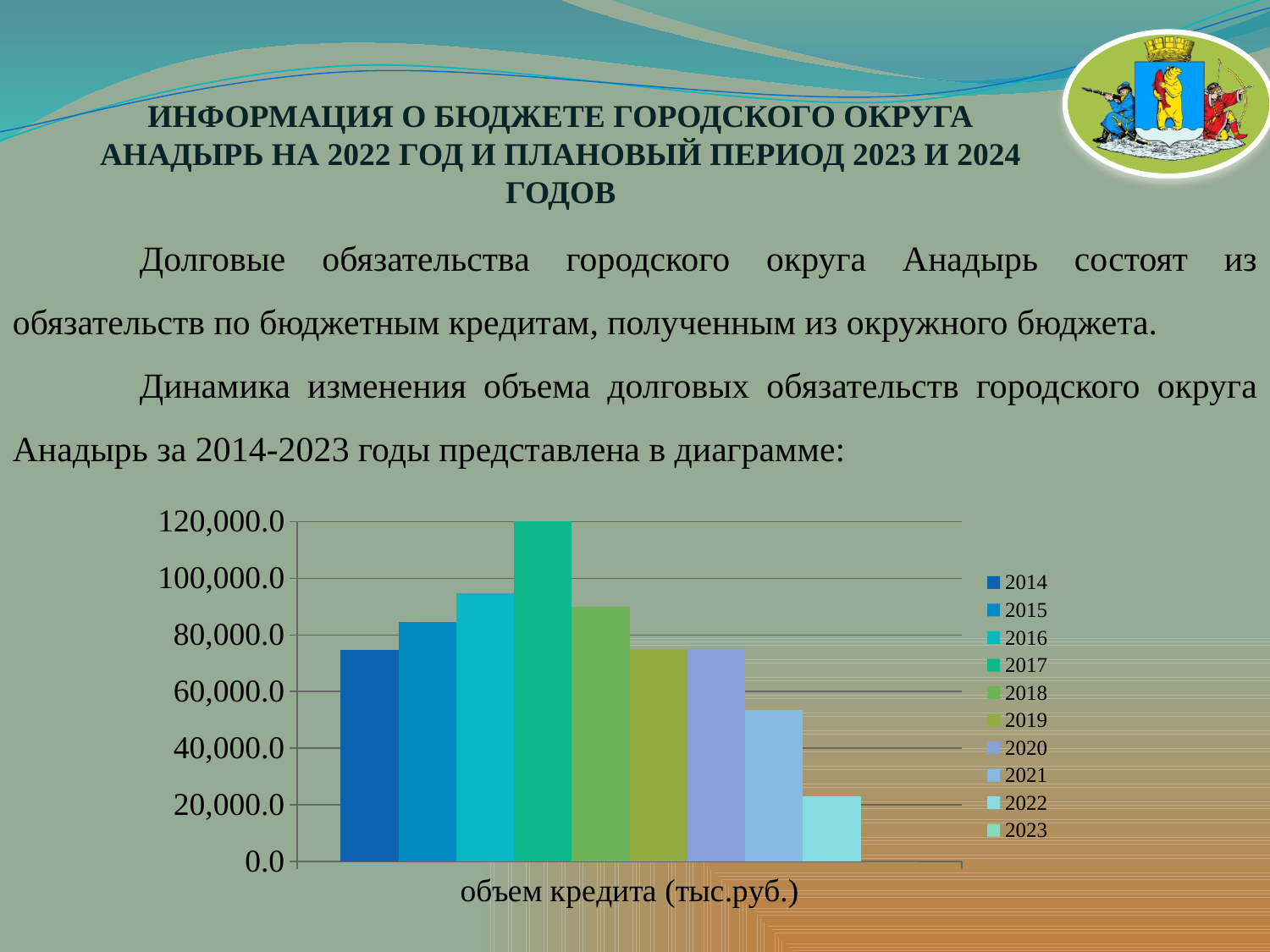
Which year has the highest bar in the chart? 2017 Is the value for 2021 greater or less than 60,000.0? less Is the value for 2022 greater or less than 40,000.0? less Is the value for 2018 greater or less than 80,000.0? greater Which is larger, the value for 2015 or the value for 2021? 2015 Do the values rise or fall from 2017 to 2022? fall What kind of chart is shown on the slide? bar chart How many series does the legend list? 10 What is the value for 2017 in the chart? 120,000.0 What is the label shown under the x axis of the chart? объем кредита (тыс.руб.)